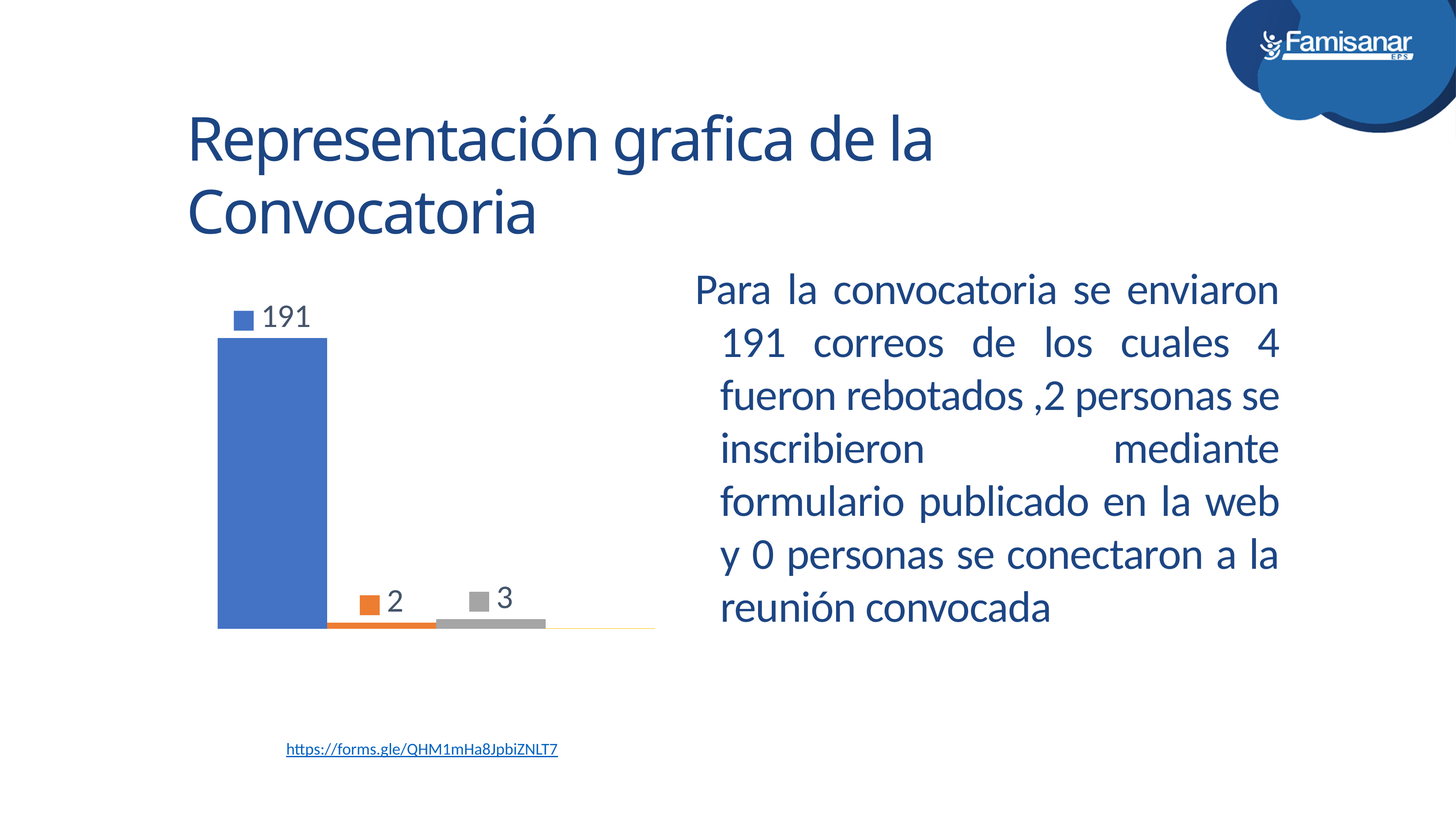
What is the total of the three labelled values in the chart? 196 What is the difference between the gray bar's value and the orange bar's value? 1 What is the difference between the blue bar's value and the gray bar's value? 188 Which bar has the highest value? the blue bar (191) Which labelled bar has the lowest value? the orange bar (2) What kind of chart is shown on the slide? bar chart What value is labelled on the gray bar? 3 What colour is the tallest bar in the chart? blue Which is larger, the value of the orange bar or the value of the gray bar? the gray bar How many bars have a printed data label in the chart? 3 What value is labelled on the orange bar? 2 What value is labelled on the blue bar? 191